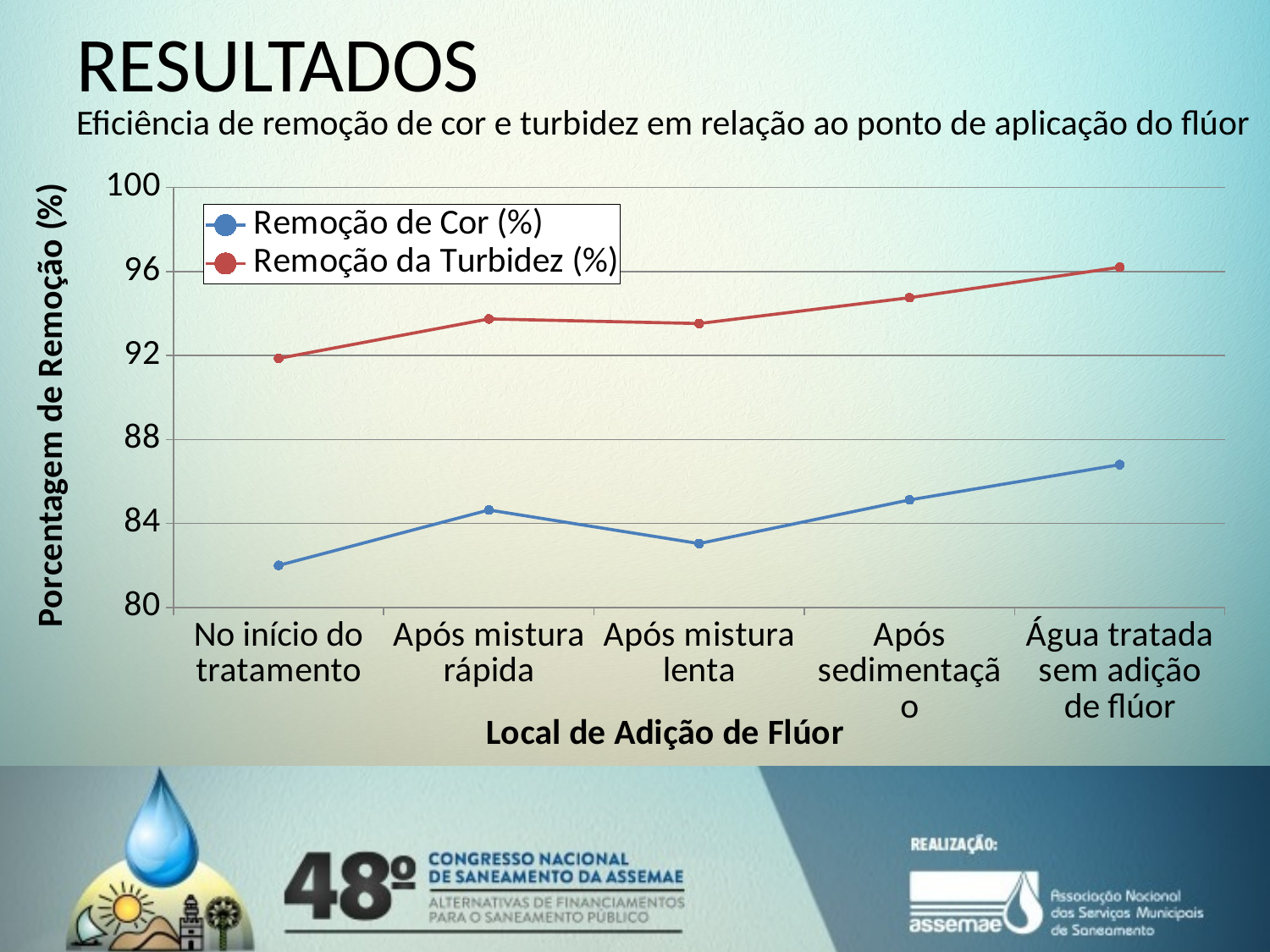
How many categories are shown on the x axis? 5 Is the value of Remoção de Cor (%) for No início do tratamento greater or less than 84? less Which category has the lowest value for Remoção de Cor (%)? No início do tratamento Which category has the highest value for Remoção de Cor (%)? Água tratada sem adição de flúor Is the value of Remoção de Cor (%) for Água tratada sem adição de flúor greater or less than 88? less What kind of chart is shown on the slide? line chart How many series does the legend list? 2 For Remoção de Cor (%), which is larger: the value for Após mistura rápida or for Após mistura lenta? Após mistura rápida Which category has the lowest value for Remoção da Turbidez (%)? No início do tratamento Which series has the higher values across all categories, Remoção de Cor (%) or Remoção da Turbidez (%)? Remoção da Turbidez (%) Is the value of Remoção da Turbidez (%) for Após sedimentação greater or less than 96? less Which category has the highest value for Remoção da Turbidez (%)? Água tratada sem adição de flúor